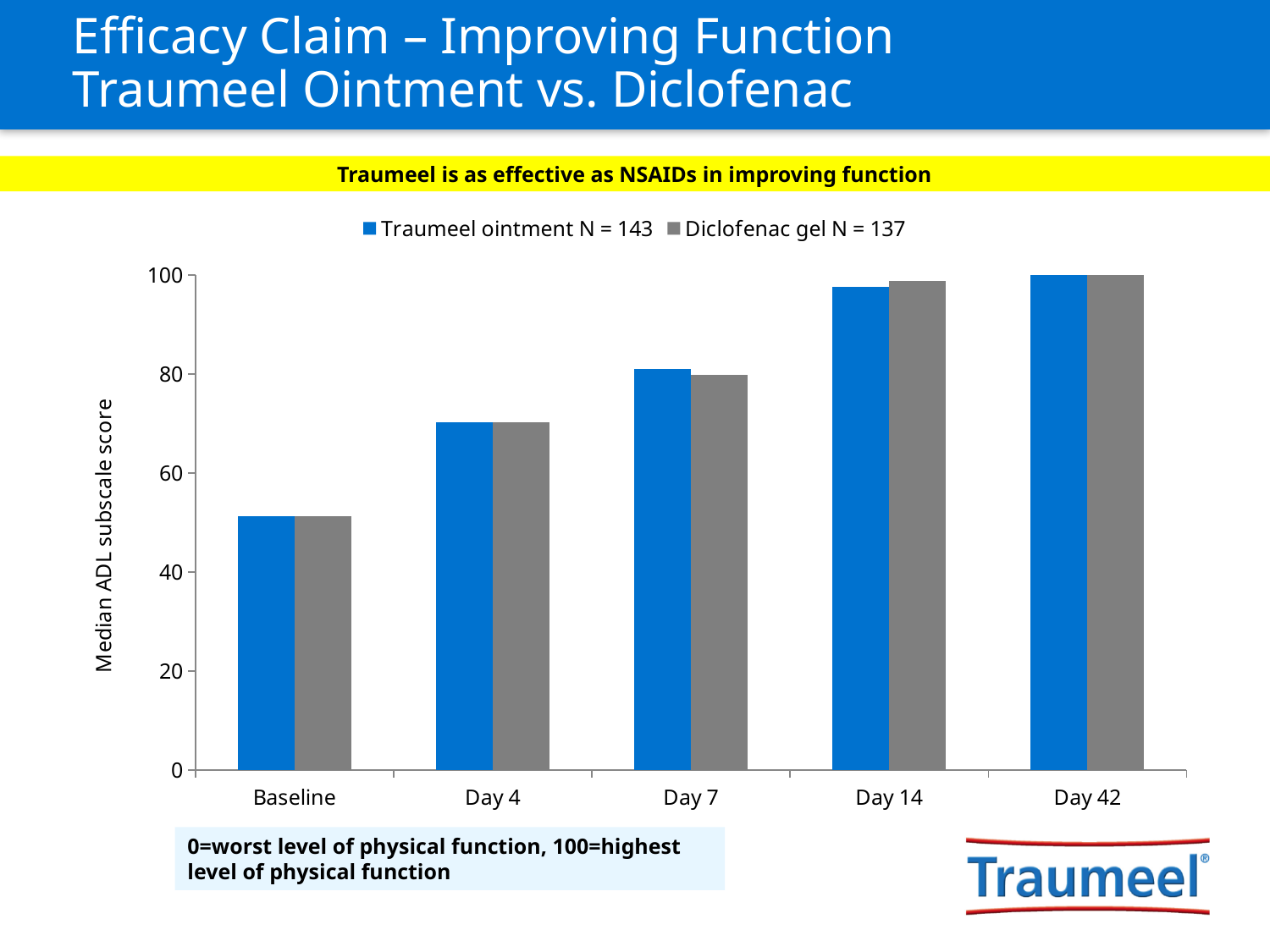
Is the Baseline value for Diclofenac gel greater or less than 40? greater Do the Median ADL subscale scores rise or fall from Baseline to Day 42? rise Is the Baseline value for Traumeel ointment greater or less than 60? less Which time point has the lowest Median ADL subscale score for Traumeel ointment? Baseline What is the sample size (N) given in the legend for Traumeel ointment? N = 143 Is the Day 14 value for Traumeel ointment greater or less than 80? greater What kind of chart is shown on the slide? bar chart How many series does the legend list? 2 Which time point has the highest Median ADL subscale score for Diclofenac gel? Day 42 How many time points (categories) are shown on the x axis? 5 What is the label of the vertical axis? Median ADL subscale score